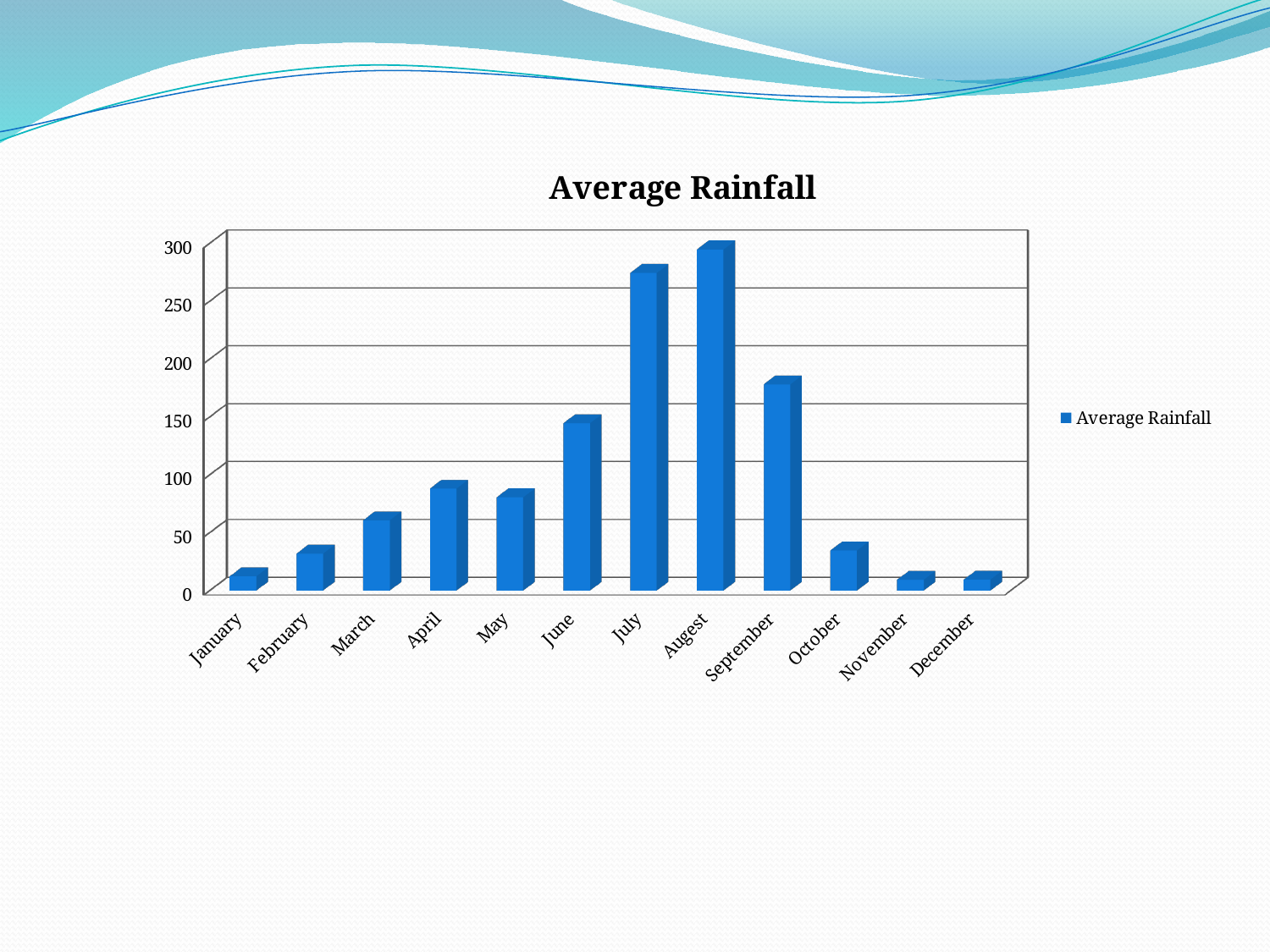
Which is larger, the value for June or the value for September? September What type of chart is shown on the slide? bar chart What is the title of the chart? Average Rainfall Do the values rise or fall from August to December? fall Is the value for October greater or less than 50? less Which is larger, the value for July or the value for September? July How many categories (months) are shown on the x axis? 12 Is the value for June greater or less than 100? greater Which month has the highest average rainfall? Augest How many series does the legend list? 1 Is the value for September greater or less than 150? greater